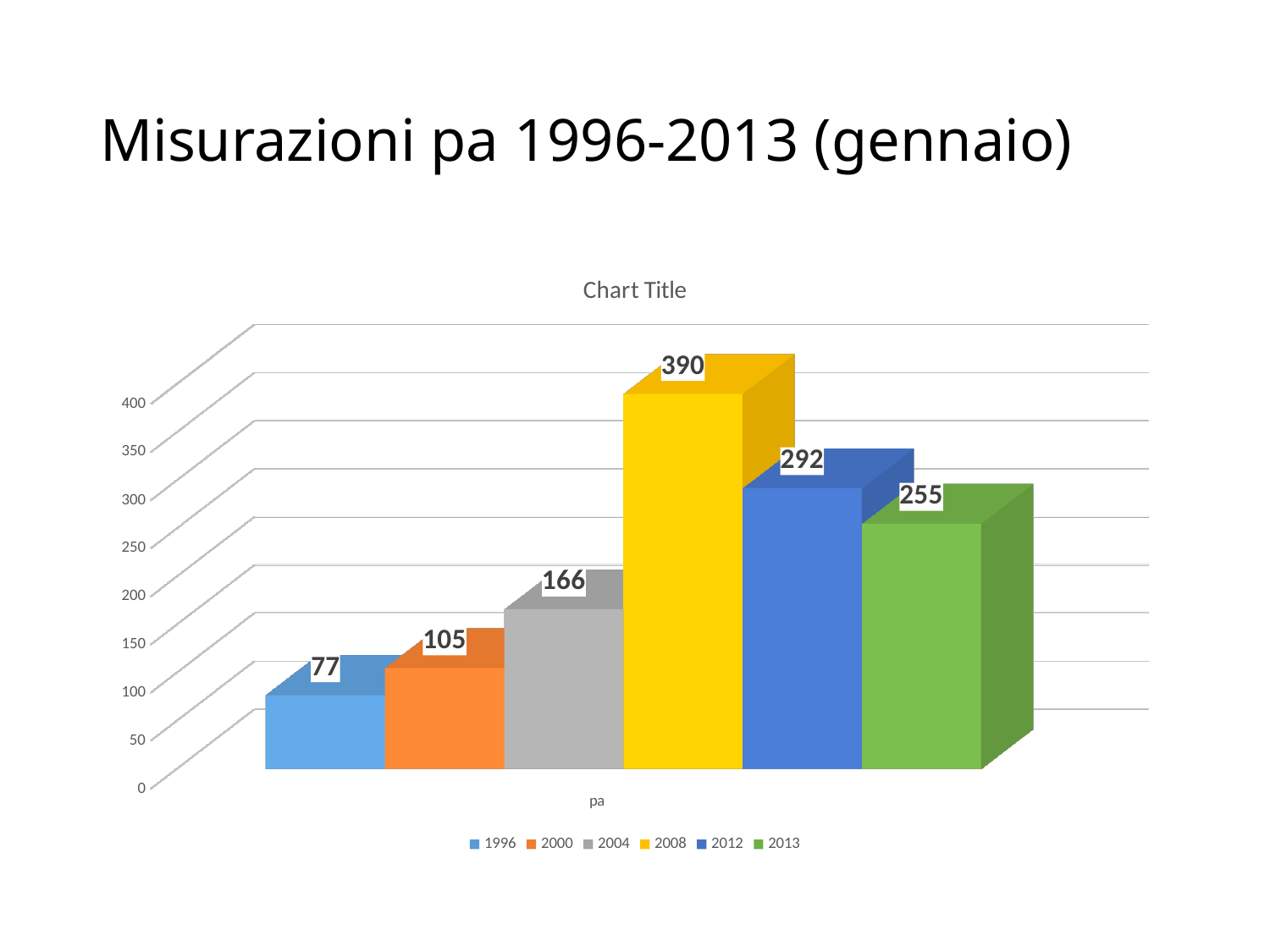
Which year has the highest value? 2008 How many series does the legend list? 6 What is the difference between the values for 2008 and 2012? 98 Which year has the lowest value? 1996 What is the value for 1996? 77 What is the label on the x axis category? pa What is the value for 2013? 255 Which is larger, the value for 2012 or the value for 2013? 2012 What colour is the bar for 2008? yellow What kind of chart is shown on the slide? bar chart What is the difference between the values for 2004 and 2000? 61 What is the value for 2008? 390